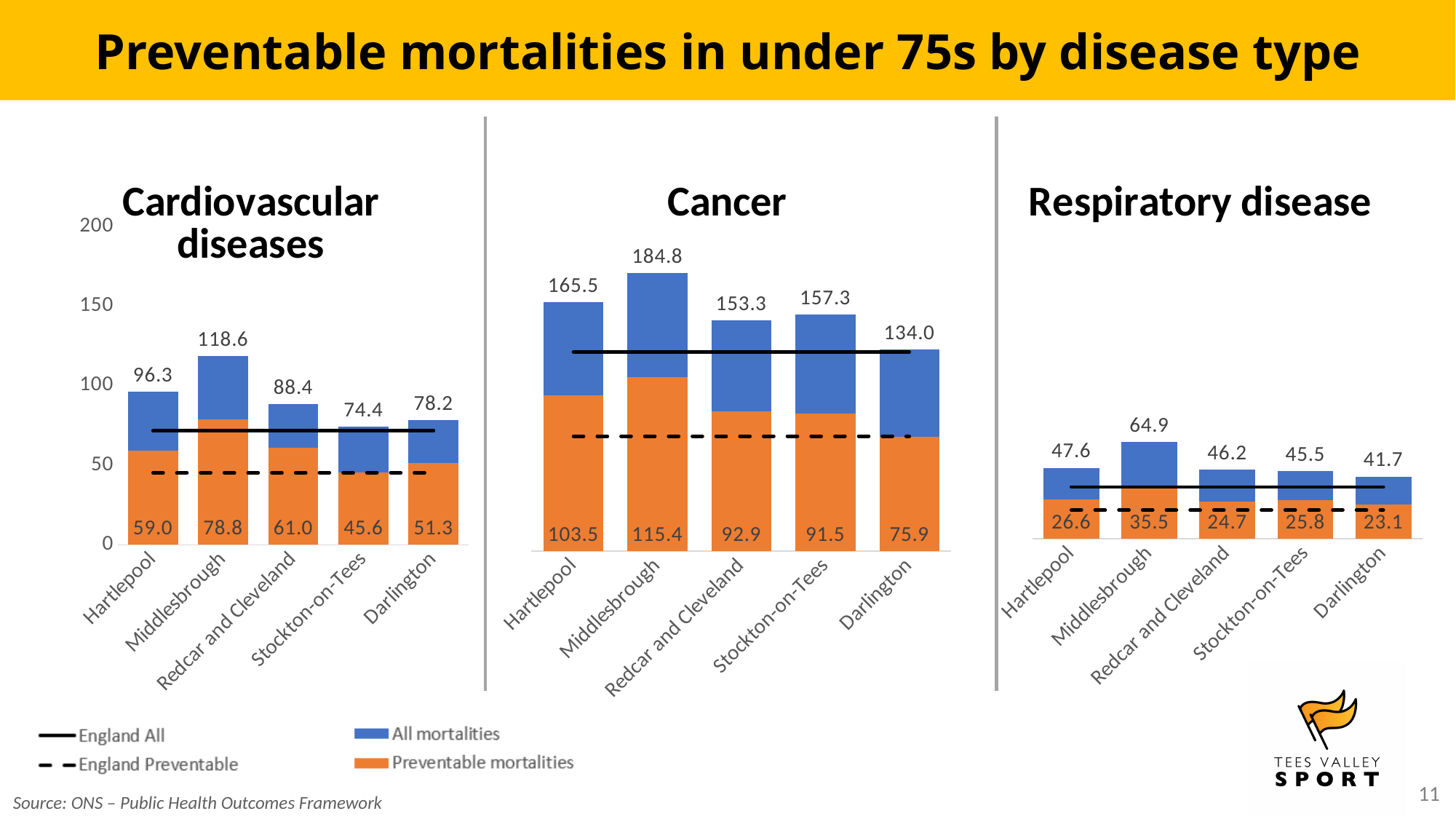
How many areas are shown on the x axis of the Cardiovascular diseases chart? 5 In the Cardiovascular diseases chart, what is the all mortalities value for Middlesbrough? 118.6 In the Respiratory disease chart, what is the all mortalities value for Darlington? 41.7 In the Cancer chart, which area has the highest all mortalities value? Middlesbrough In the Cancer chart, which area has the lowest preventable mortalities value? Darlington In the Cardiovascular diseases chart, what is the preventable mortalities value for Stockton-on-Tees? 45.6 How many entries does the legend at the bottom of the slide list? 4 In the Respiratory disease chart, what is the difference between the preventable mortalities values for Middlesbrough and Hartlepool? 8.9 In the Cardiovascular diseases chart, is the all mortalities value for Hartlepool greater or less than 100? less In the Cancer chart, what is the difference between the all mortalities values for Hartlepool and Darlington? 31.5 In the Respiratory disease chart, which has the larger preventable mortalities value, Hartlepool or Redcar and Cleveland? Hartlepool What kind of chart is the Cancer chart? Combination bar and line chart